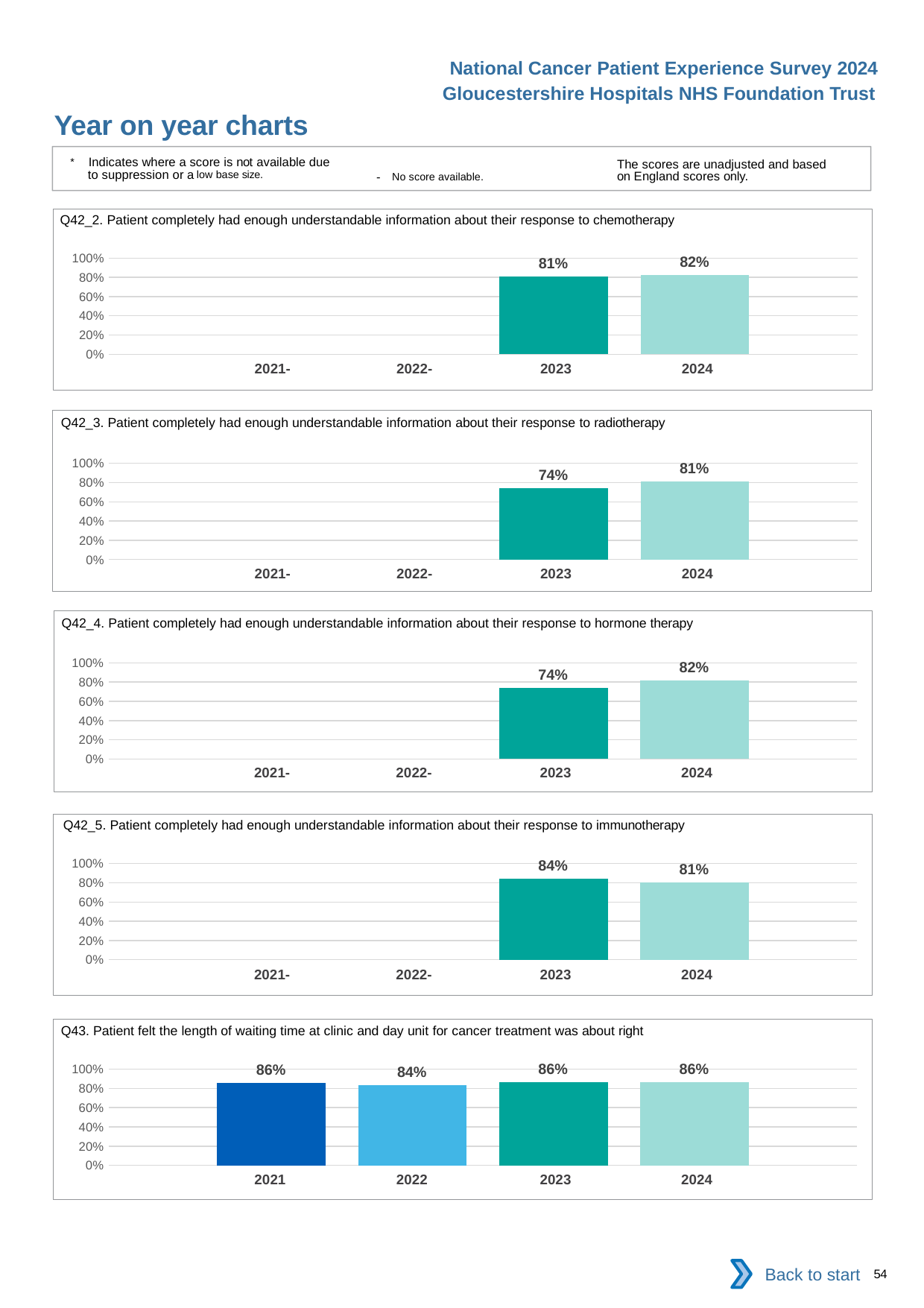
In the Q42_4 chart (hormone therapy), what is the difference between the 2024 and 2023 values? 8 percentage points In the Q42_5 chart (immunotherapy), did the value rise or fall from 2023 to 2024? fall In the Q43 chart (waiting time at clinic and day unit), what is the value for 2022? 84% In the Q42_2 chart (chemotherapy), what is the value for 2024? 82% In the Q42_3 chart (radiotherapy), what is the difference between the 2024 and 2023 values? 7 percentage points In the Q43 chart (waiting time at clinic and day unit), how many years have a bar plotted? 4 What type of chart is the Q43 chart? bar chart In the Q42_2 chart (chemotherapy), how many years have a bar plotted? 2 In the Q42_3 chart (radiotherapy), what is the value for 2023? 74% In the Q42_5 chart (immunotherapy), what is the value for 2023? 84% In the Q43 chart (waiting time at clinic and day unit), which year has the lowest value? 2022 In the Q42_4 chart (hormone therapy), which year has the higher value, 2023 or 2024? 2024